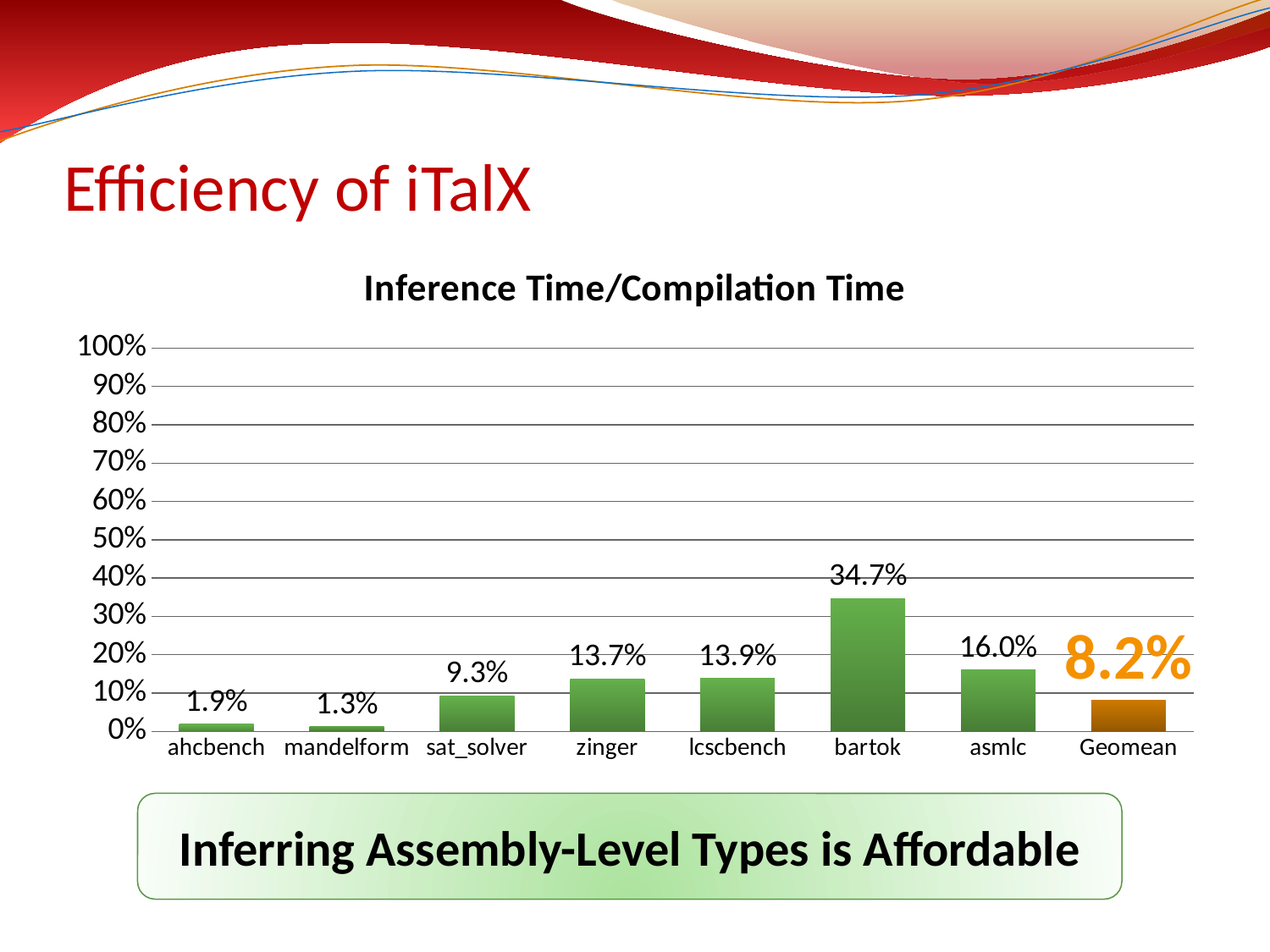
What kind of chart is shown on the slide? bar chart What is the title of the chart? Inference Time/Compilation Time What is the difference between the values for bartok and asmlc? 18.7% Which is larger, the value for zinger or the value for asmlc? asmlc What is the value for sat_solver? 9.3% Which category has the lowest value? mandelform Is the value for bartok greater or less than 30%? greater What is the value for bartok? 34.7% How many categories are shown on the x axis? 8 What is the Geomean value shown on the chart? 8.2% Which category has the highest value? bartok Which bar is coloured differently (orange) from the others? Geomean